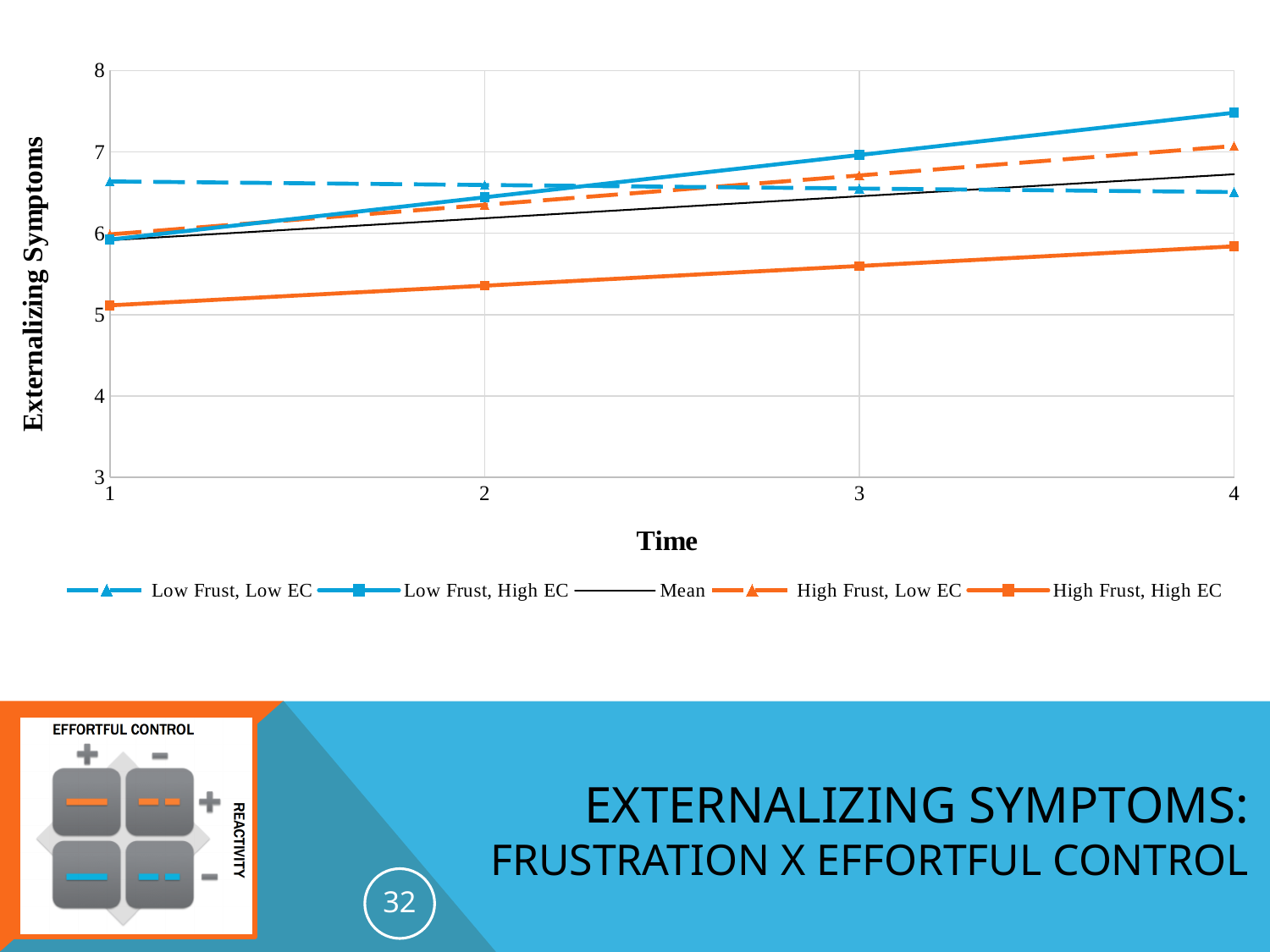
Is the value for High Frust, High EC at Time 1 greater or less than 6? less How many series does the legend list? 5 Is the value for Low Frust, Low EC at Time 4 greater or less than 7? less What kind of chart is shown on the slide? line chart What is the title of the y axis? Externalizing Symptoms Do the values for Low Frust, High EC rise or fall from Time 1 to Time 4? rise What is the title of the x axis? Time Which series has the highest value at Time 4? Low Frust, High EC At Time 1, which is larger: Low Frust, Low EC or High Frust, High EC? Low Frust, Low EC Is the value for Low Frust, High EC at Time 4 greater or less than 7? greater How many time points are plotted along the x axis? 4 Which series has the lowest value at Time 1? High Frust, High EC